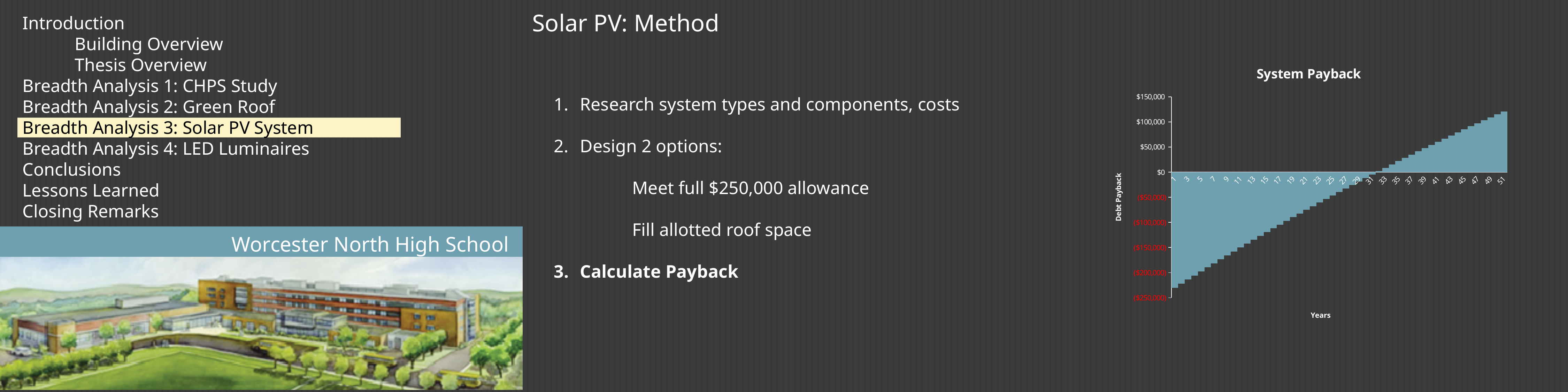
In the System Payback chart, which is larger, the value for year 51 or the value for year 1? year 51 In the System Payback chart, which year has the lowest value? 1 In the System Payback chart, is the value for year 11 greater or less than ($100,000)? less What kind of chart is the System Payback chart? bar chart What is the x-axis title of the System Payback chart? Years In the System Payback chart, do the values rise or fall as the years increase? rise In the System Payback chart, which year has the highest value? 51 In the System Payback chart, is the value for year 21 greater or less than $0? less In the System Payback chart, is the value for year 51 greater or less than $100,000? greater What is the title of the chart on the right of the slide? System Payback